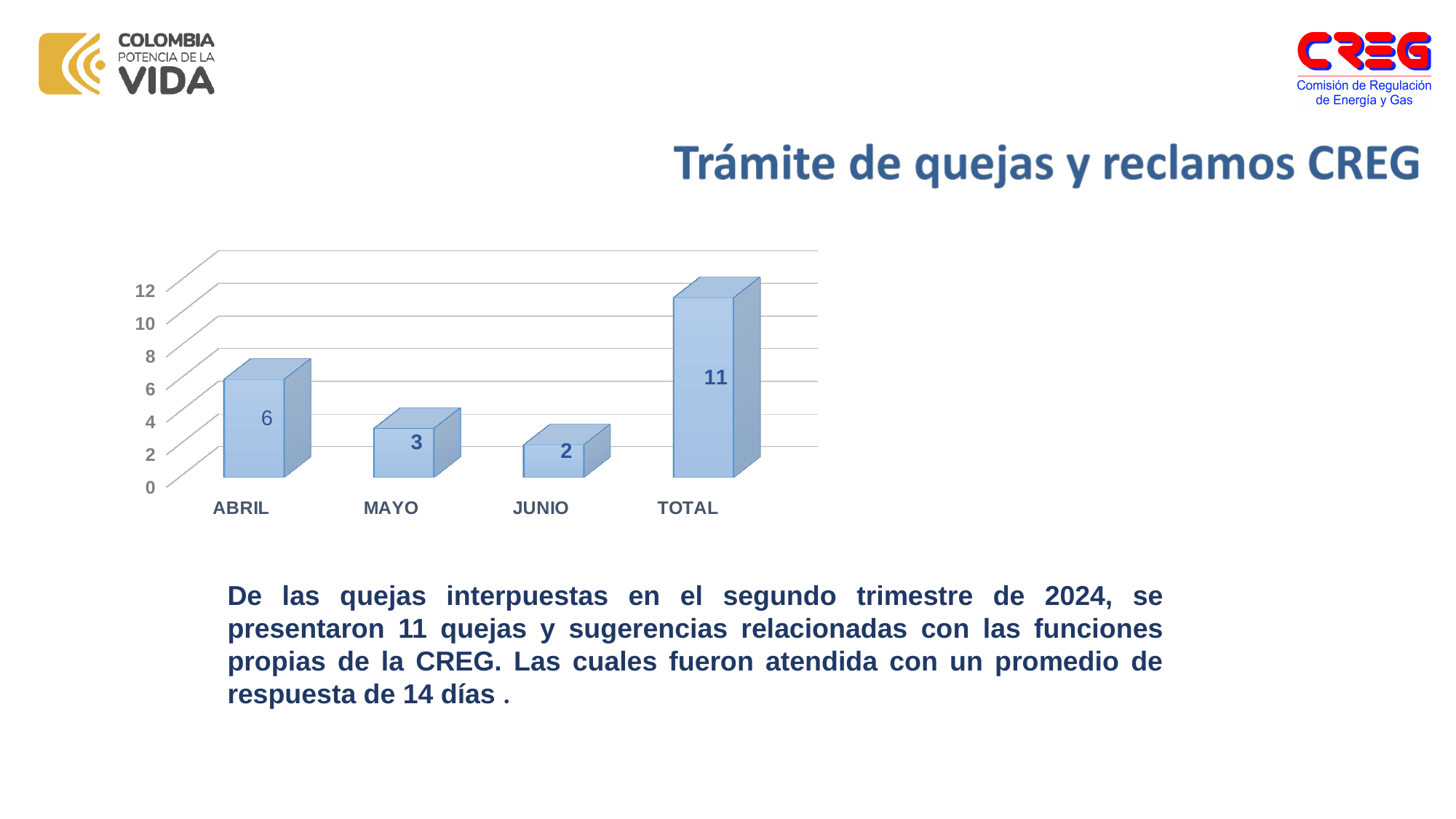
What kind of chart is shown on the slide? bar chart What is the value for JUNIO? 2 Which category has the lowest value? JUNIO What is the value for ABRIL? 6 What is the value for TOTAL? 11 Do the values rise or fall from ABRIL to JUNIO? fall What is the value for MAYO? 3 How many categories are shown on the x axis? 4 Which category has the highest value? TOTAL Is the value for TOTAL greater or less than 10? greater What is the difference between the values for ABRIL and MAYO? 3 Which is larger, the value for MAYO or the value for JUNIO? MAYO